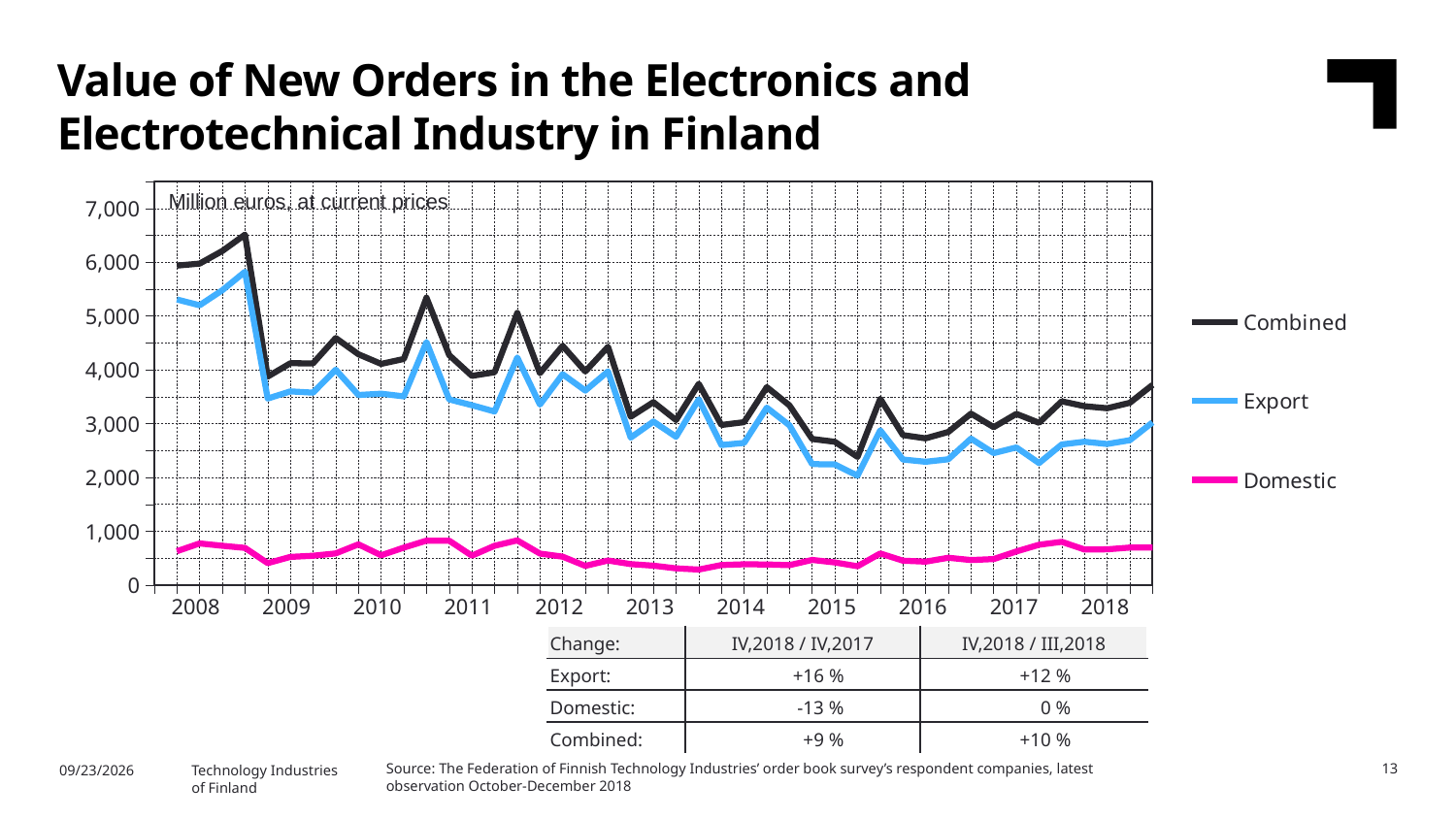
Does the Combined series generally rise or fall from 2008 to 2015? fall How many year labels are shown on the x axis? 11 Is the Domestic series at the start of 2008 greater or less than 1,000? less Is the Export value at the end of 2018 greater or less than 2,000? greater What kind of chart is shown on the slide? Line chart What unit label is printed inside the chart area? Million euros, at current prices Which series has the highest values throughout the chart? Combined Is the lowest Combined value in 2015 greater or less than 3,000? less What are the three series named in the legend? Combined, Export, Domestic Which series has the lowest values throughout the chart? Domestic How many series does the legend list? 3